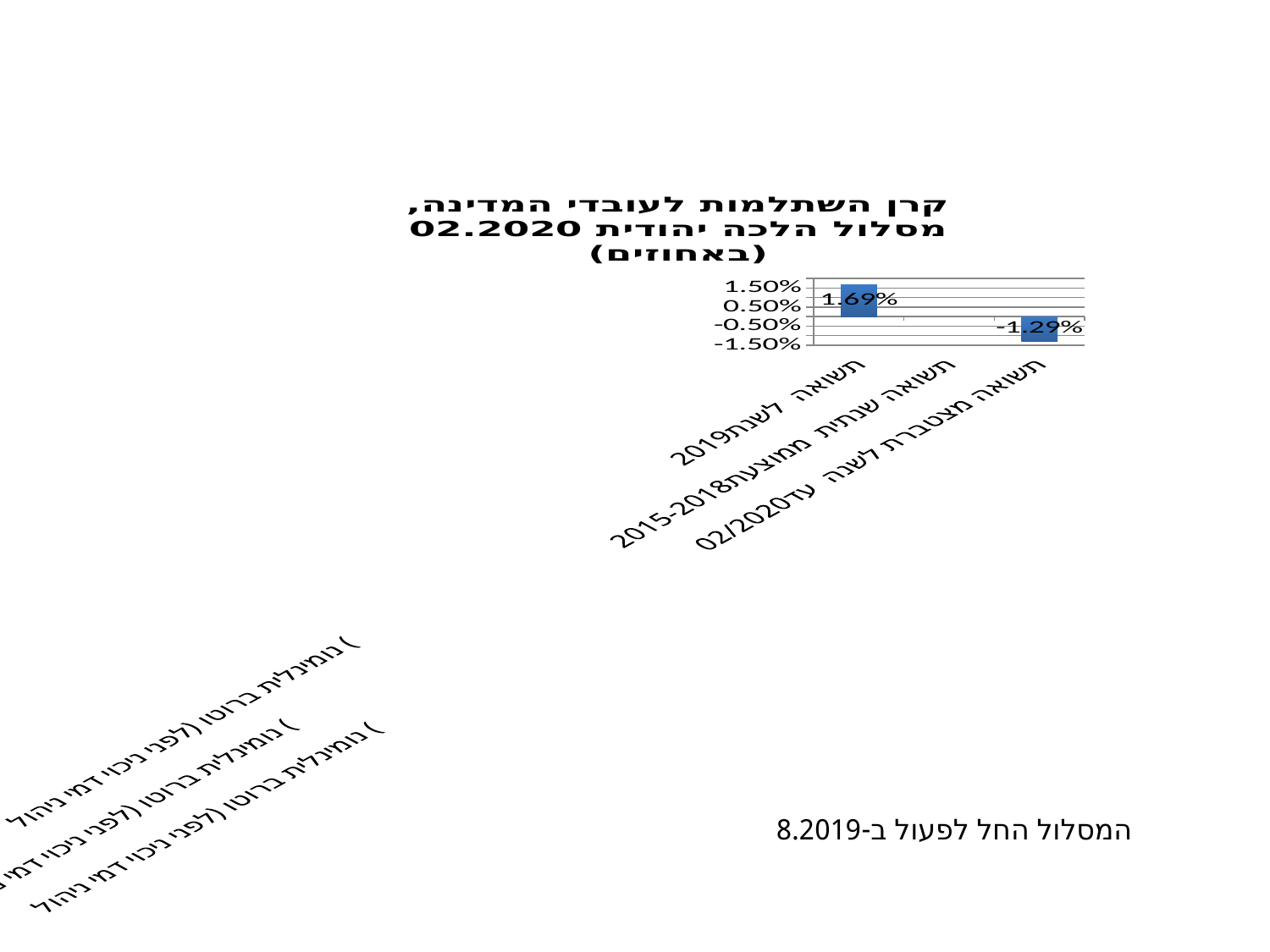
Is the value for תשואה מצטברת לשנה עד 02/2020 greater or less than -0.50%? less What is the title of the chart? קרן השתלמות לעובדי המדינה, מסלול הלכה יהודית 02.2020 (באחוזים) Which category has the highest value? תשואה לשנת 2019 What is the value for תשואה מצטברת לשנה עד 02/2020? -1.29% Is the value for תשואה לשנת 2019 greater or less than 0.50%? greater What is the difference between the value for תשואה לשנת 2019 and the value for תשואה מצטברת לשנה עד 02/2020? 2.98% What is the value for תשואה לשנת 2019? 1.69% What is the highest value shown on the y axis of the chart? 1.50% What type of chart is shown on the slide? bar chart How many categories are shown on the x axis of the chart? 3 Which category has the lowest value? תשואה מצטברת לשנה עד 02/2020 Which is larger: the value for תשואה לשנת 2019 or the value for תשואה מצטברת לשנה עד 02/2020? תשואה לשנת 2019